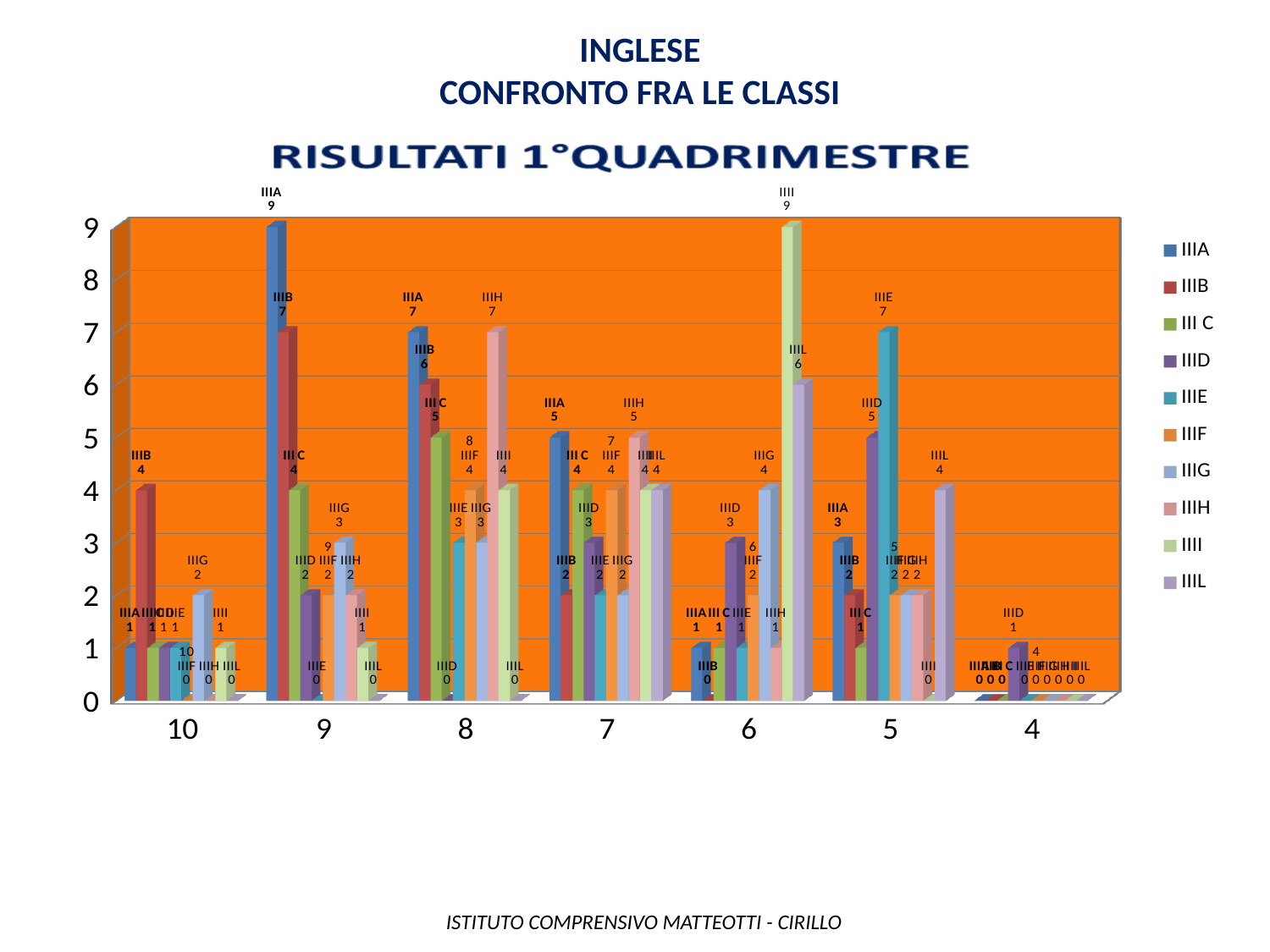
What is the difference between IIIA and IIIB at category 9? 2 What kind of chart is shown? bar chart How many categories are shown on the x axis? 7 What is the value for IIIE at category 5? 7 Which series has the highest value at category 6? IIII What is the value for IIIL at category 6? 6 What is the value for IIIA at category 9? 9 Which series has the highest value at category 9? IIIA What is the value for IIIH at category 8? 7 What is the value for IIII at category 6? 9 At category 8, which is larger: IIIA or IIIB? IIIA How many series does the legend list? 10